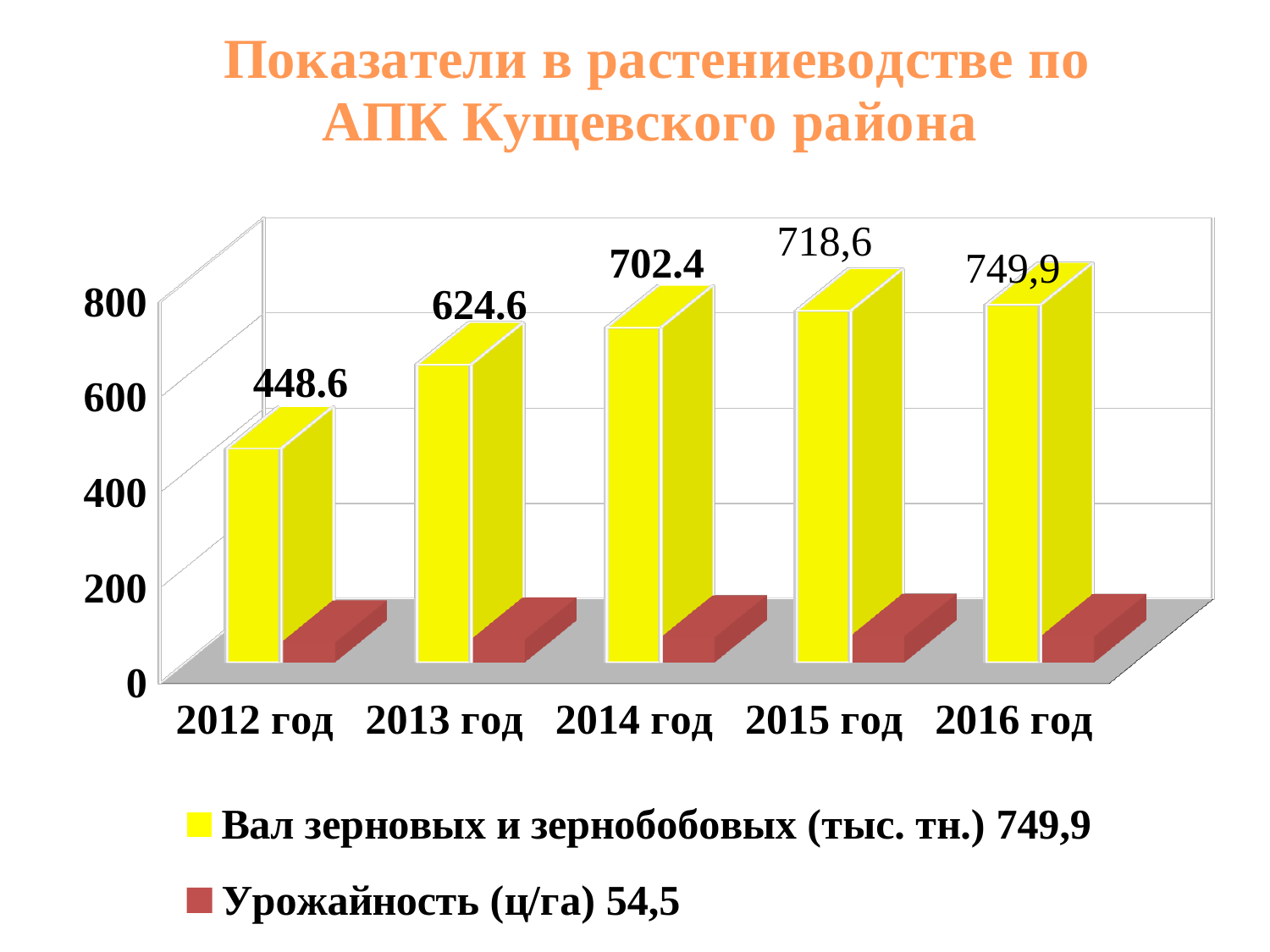
What is the value of Вал зерновых и зернобобовых (тыс. тн.) for 2012 год? 448.6 What is the value of Вал зерновых и зернобобовых (тыс. тн.) for 2014 год? 702.4 By how much did Вал зерновых и зернобобовых (тыс. тн.) increase from 2012 год to 2013 год? 176 How many years are shown on the x axis of the chart? 5 What is the difference in Вал зерновых и зернобобовых (тыс. тн.) between 2014 год and 2013 год? 77.8 Which year has the lowest value for Вал зерновых и зернобобовых (тыс. тн.)? 2012 год What is the value of Вал зерновых и зернобобовых (тыс. тн.) for 2016 год? 749,9 Does the value of Вал зерновых и зернобобовых (тыс. тн.) rise or fall from 2012 год to 2016 год? rise How many series does the legend list? 2 Is the value of Урожайность (ц/га) for 2014 год greater or less than 200? less Which year has the highest value for Вал зерновых и зернобобовых (тыс. тн.)? 2016 год Which is larger, the Вал зерновых и зернобобовых value for 2013 год or for 2015 год? 2015 год